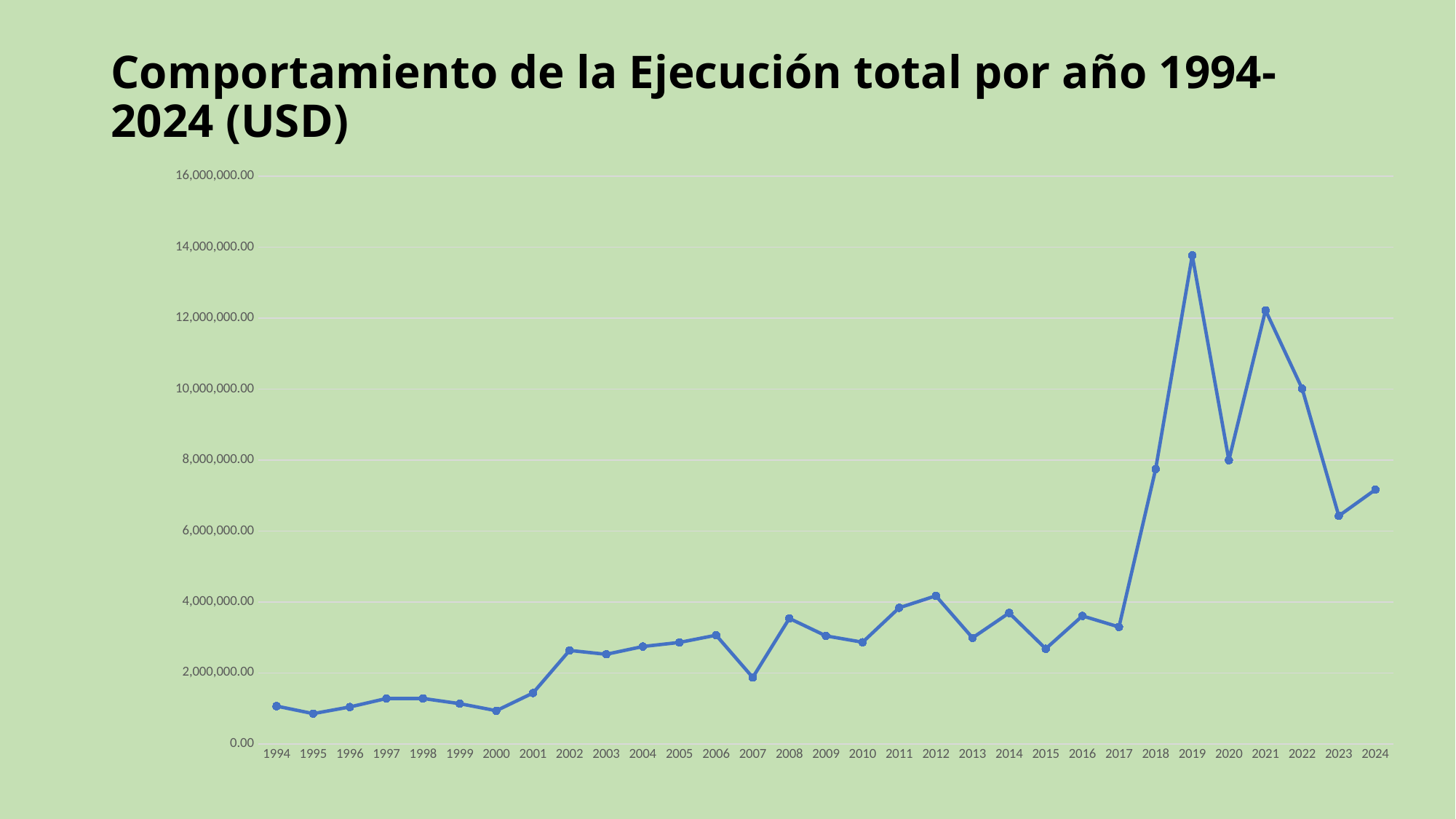
How many years (data points) are plotted on the x axis? 31 Which year has the highest value? 2019 Is the value for 2024 greater or less than 8,000,000.00? less Is the value for 2021 greater or less than 10,000,000.00? greater Which is larger, the value for 2019 or the value for 2021? 2019 Which is larger, the value for 2020 or the value for 2022? 2022 Do the values rise or fall from 2021 to 2023? fall What is the title of the chart? Comportamiento de la Ejecución total por año 1994-2024 (USD) Is the value for 2019 greater or less than 12,000,000.00? greater What kind of chart is shown on the slide? Line chart Do the values rise or fall from 2017 to 2019? rise